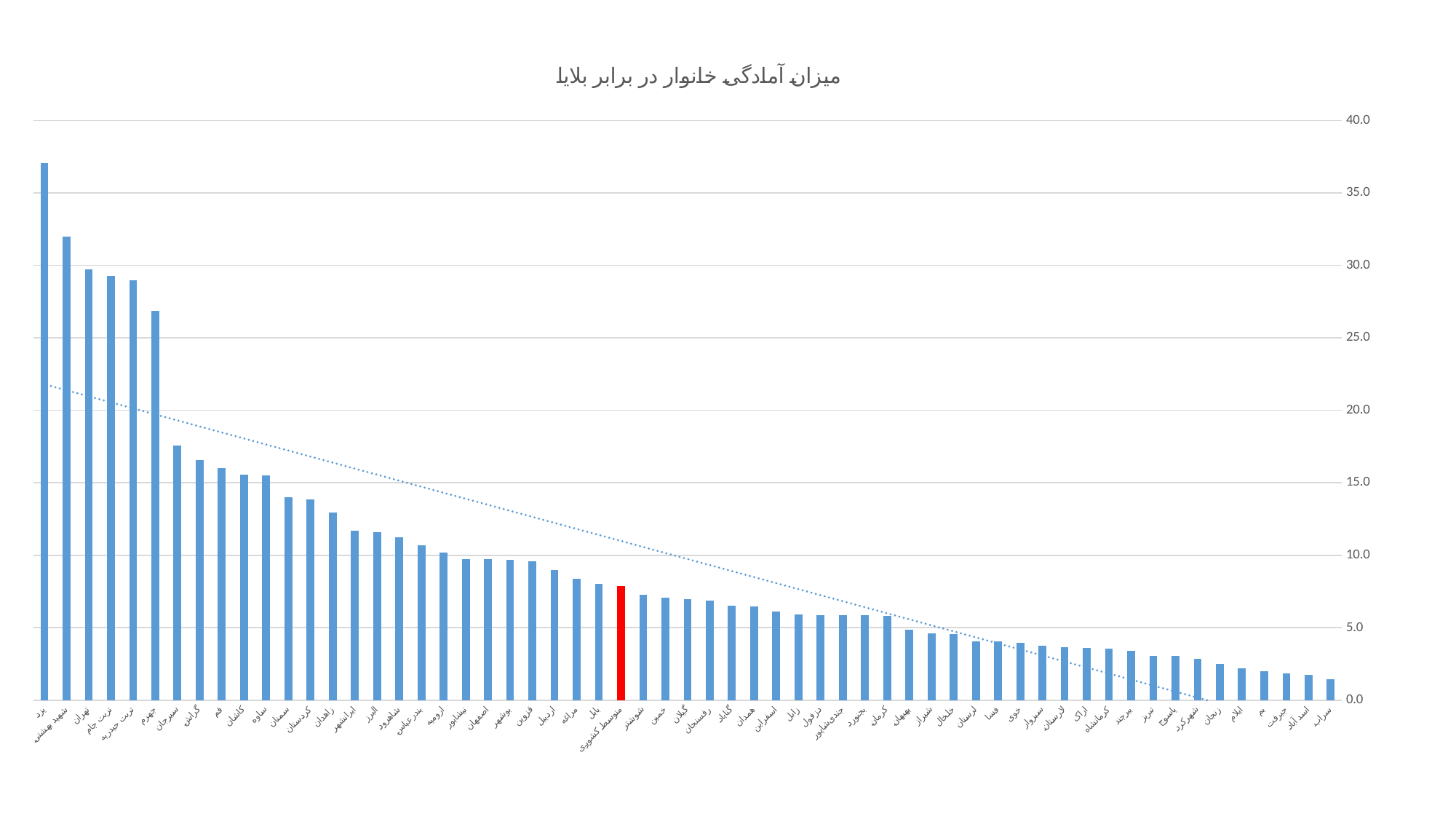
Is the value for کردستان greater or less than 15.0? less Which category is drawn with a red bar instead of a blue one? متوسط کشوری Is the value for متوسط کشوری greater or less than 10.0? less What kind of chart is shown on the slide? bar chart Is the value for سیرجان greater or less than 20.0? less Which category has the highest bar? یزد Which is larger, the value for تهران or the value for سراب? تهران Which category has the lowest bar? سراب Do the bar values rise or fall moving from left to right along the x axis? fall What is the title of the chart? میزان آمادگی خانوار در برابر بلایا